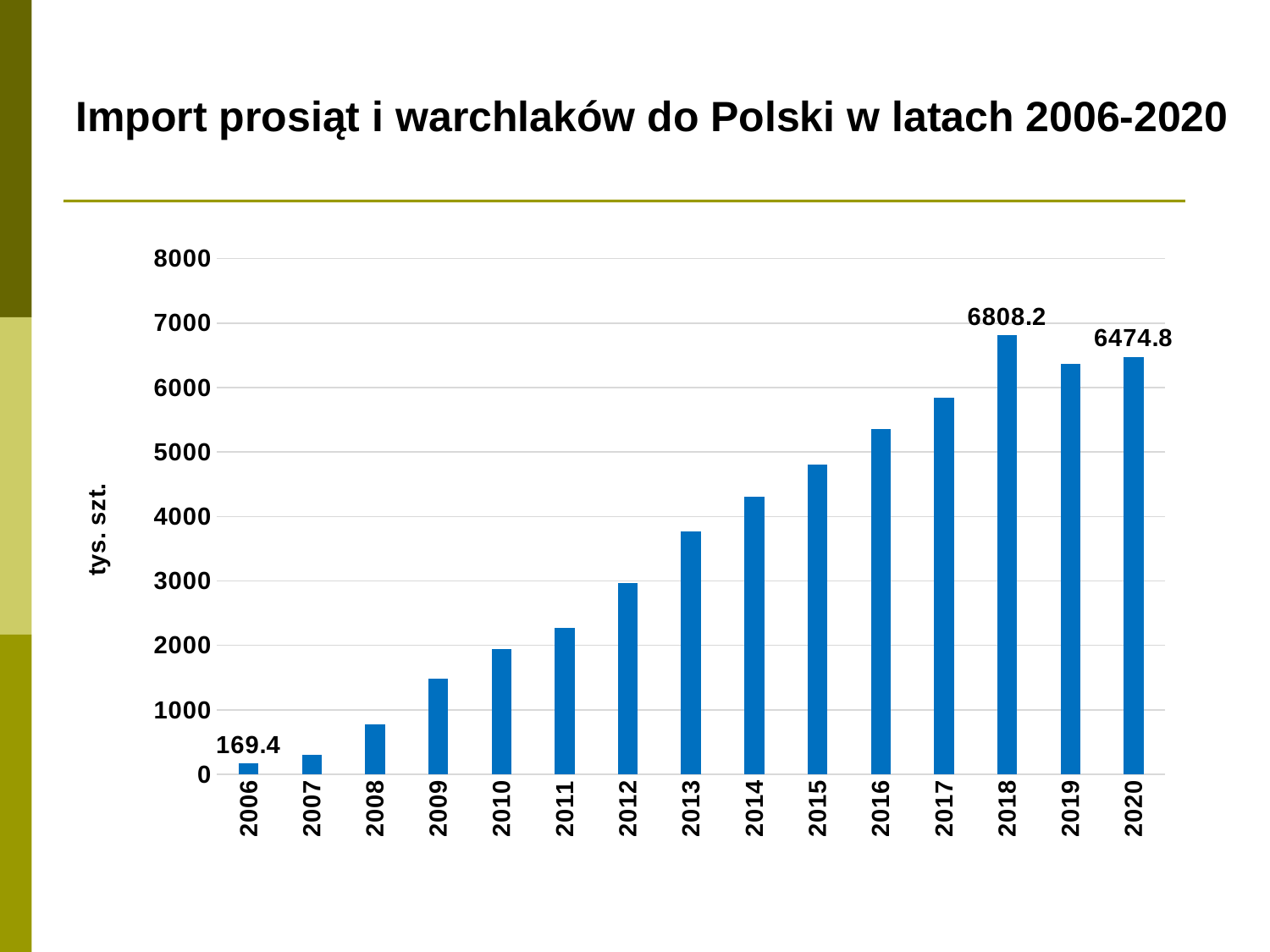
What is the value for 2018? 6808.2 Which year has the highest value? 2018 Which year has the lowest value? 2006 How many years are shown on the x axis? 15 Is the value for 2010 greater or less than 2000? less What is the label on the y axis? tys. szt. Which is larger, the value for 2014 or the value for 2016? 2016 What is the difference between the values for 2018 and 2020? 333.4 What is the value for 2020? 6474.8 What is the value for 2006? 169.4 What kind of chart is this? bar chart Is the value for 2013 greater or less than 3000? greater